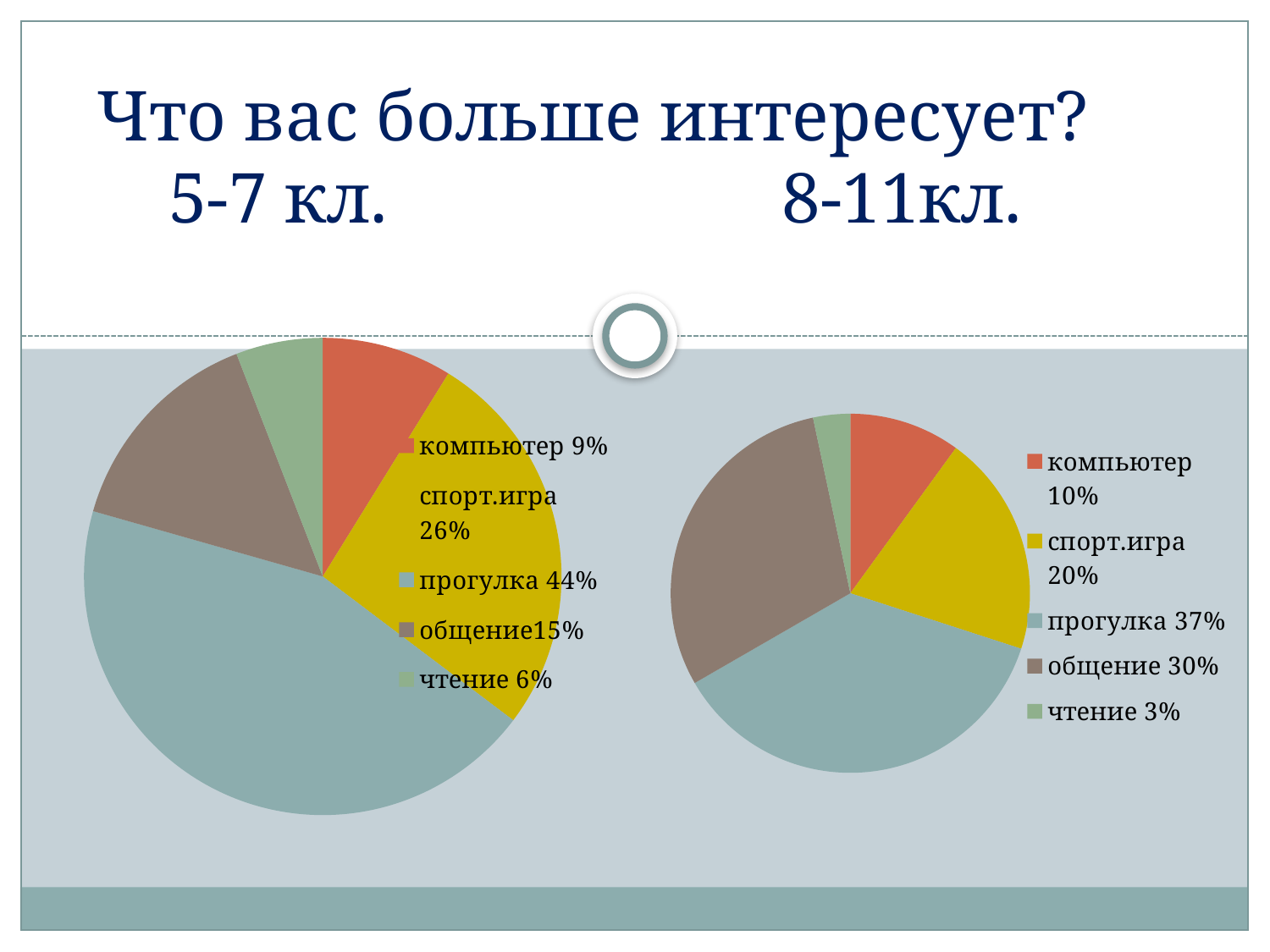
In the left pie chart (5-7 кл.), what is the share for чтение? 6% In the right pie chart (8-11кл.), what is the difference between the shares for прогулка and общение? 7% What type of chart is used on the slide for 8-11кл.? pie chart In the right pie chart (8-11кл.), what share is shown for общение? 30% In the left pie chart (5-7 кл.), which category has the largest share? прогулка What is the title of the slide? Что вас больше интересует? In the right pie chart (8-11кл.), which category has the smallest share? чтение In the left pie chart (5-7 кл.), which is larger: спорт.игра or общение? спорт.игра In the left pie chart (5-7 кл.), what share is shown for прогулка? 44% How many categories does the left pie chart (5-7 кл.) show? 5 In the left pie chart (5-7 кл.), which category has the smallest share? чтение Which chart shows a larger share for компьютер: the left (5-7 кл.) or the right (8-11кл.)? the right (8-11кл.)